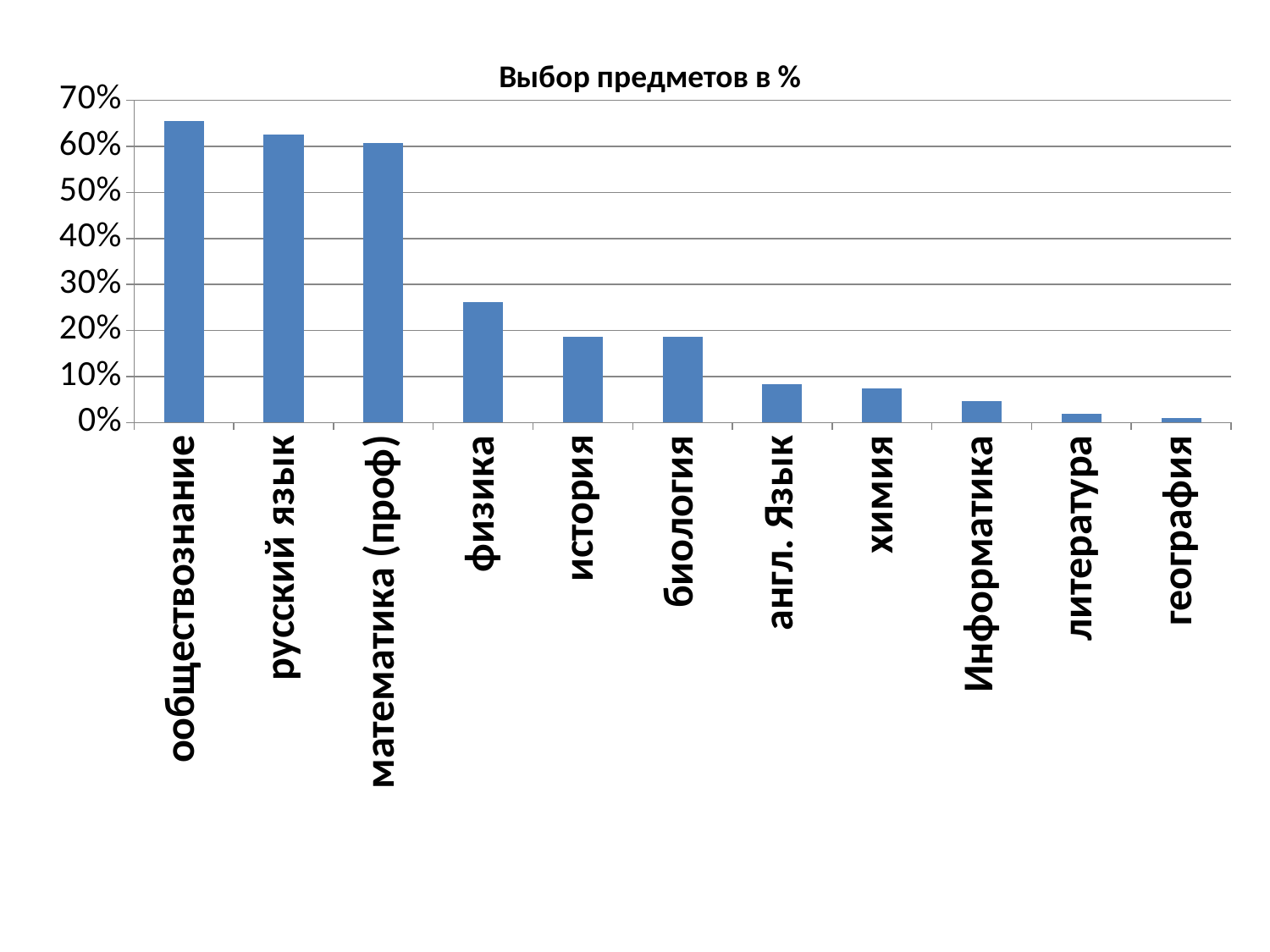
Which is larger, the value for англ. Язык or the value for литература? англ. Язык Do the values rise or fall moving from left to right along the x axis? fall Is the value for физика greater or less than 30%? less Is the value for обществознание greater or less than 60%? greater What is the title of the chart? Выбор предметов в % Is the value for математика (проф) greater or less than 50%? greater Which subject has the highest value? ообществознание How many subjects (categories) are shown on the chart? 11 Which subject has the lowest value? география What kind of chart is shown on the slide? bar chart Which is larger, the value for русский язык or the value for физика? русский язык